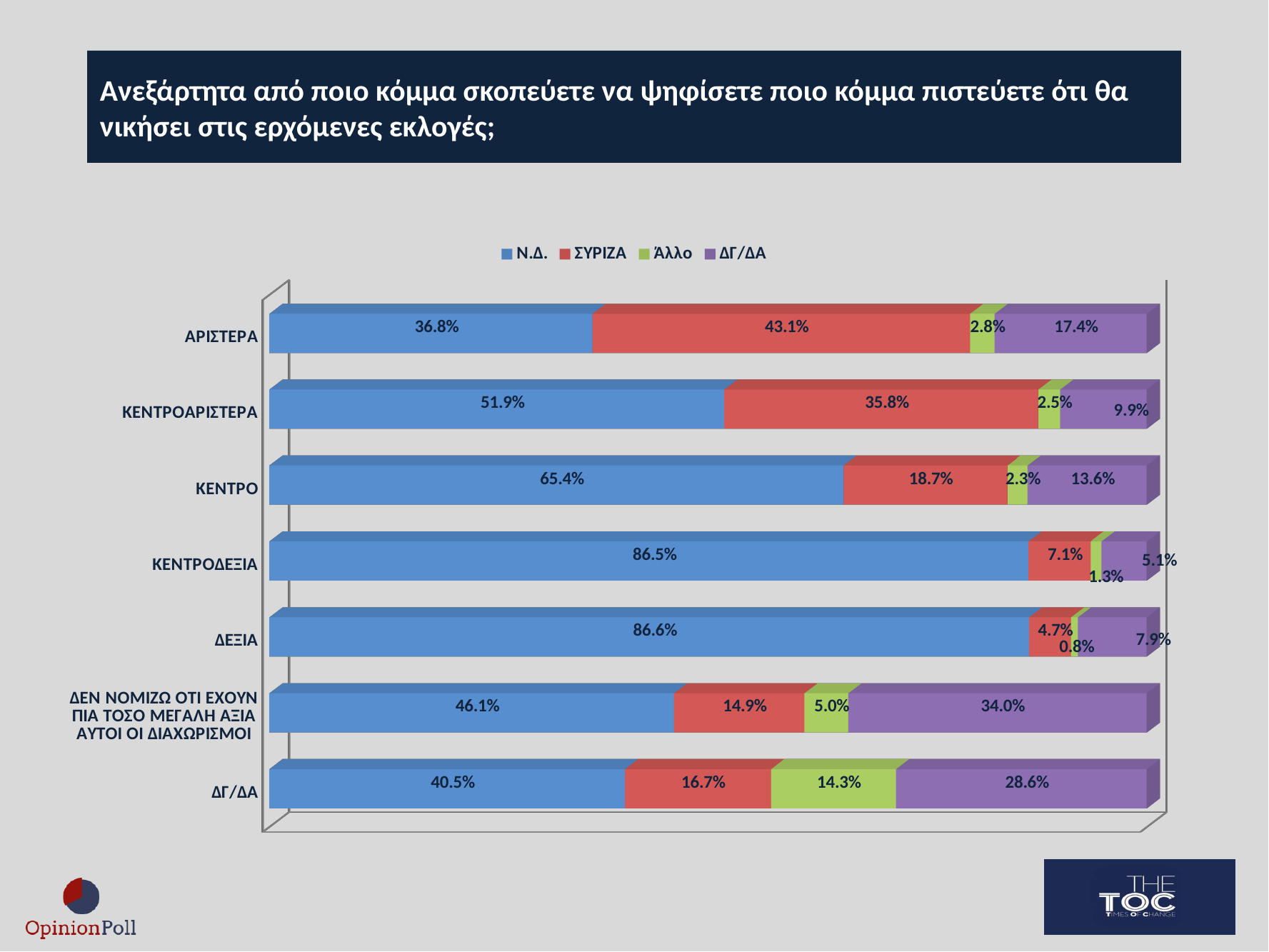
Which is larger: the Ν.Δ. value for ΚΕΝΤΡΟΑΡΙΣΤΕΡΑ or the Ν.Δ. value for ΔΓ/ΔΑ? ΚΕΝΤΡΟΑΡΙΣΤΕΡΑ In the ΑΡΙΣΤΕΡΑ category, how much larger is the ΣΥΡΙΖΑ value than the Ν.Δ. value? 6.3 percentage points Which category has the lowest Ν.Δ. value? ΑΡΙΣΤΕΡΑ How many categories are shown on the chart? 7 What kind of chart is shown on the slide? Stacked bar chart What percentage of ΚΕΝΤΡΟ respondents believe Ν.Δ. will win the upcoming elections? 65.4% How many series does the legend list? 4 Which category has the lowest Άλλο value? ΔΕΞΙΑ What is the Άλλο value for the ΔΓ/ΔΑ category? 14.3% Which category has the highest ΣΥΡΙΖΑ value? ΑΡΙΣΤΕΡΑ What is the ΔΓ/ΔΑ value for the category 'ΔΕΝ ΝΟΜΙΖΩ ΟΤΙ ΕΧΟΥΝ ΠΙΑ ΤΟΣΟ ΜΕΓΑΛΗ ΑΞΙΑ ΑΥΤΟΙ ΟΙ ΔΙΑΧΩΡΙΣΜΟΙ'? 34.0% What is the ΣΥΡΙΖΑ value for the ΑΡΙΣΤΕΡΑ category? 43.1%